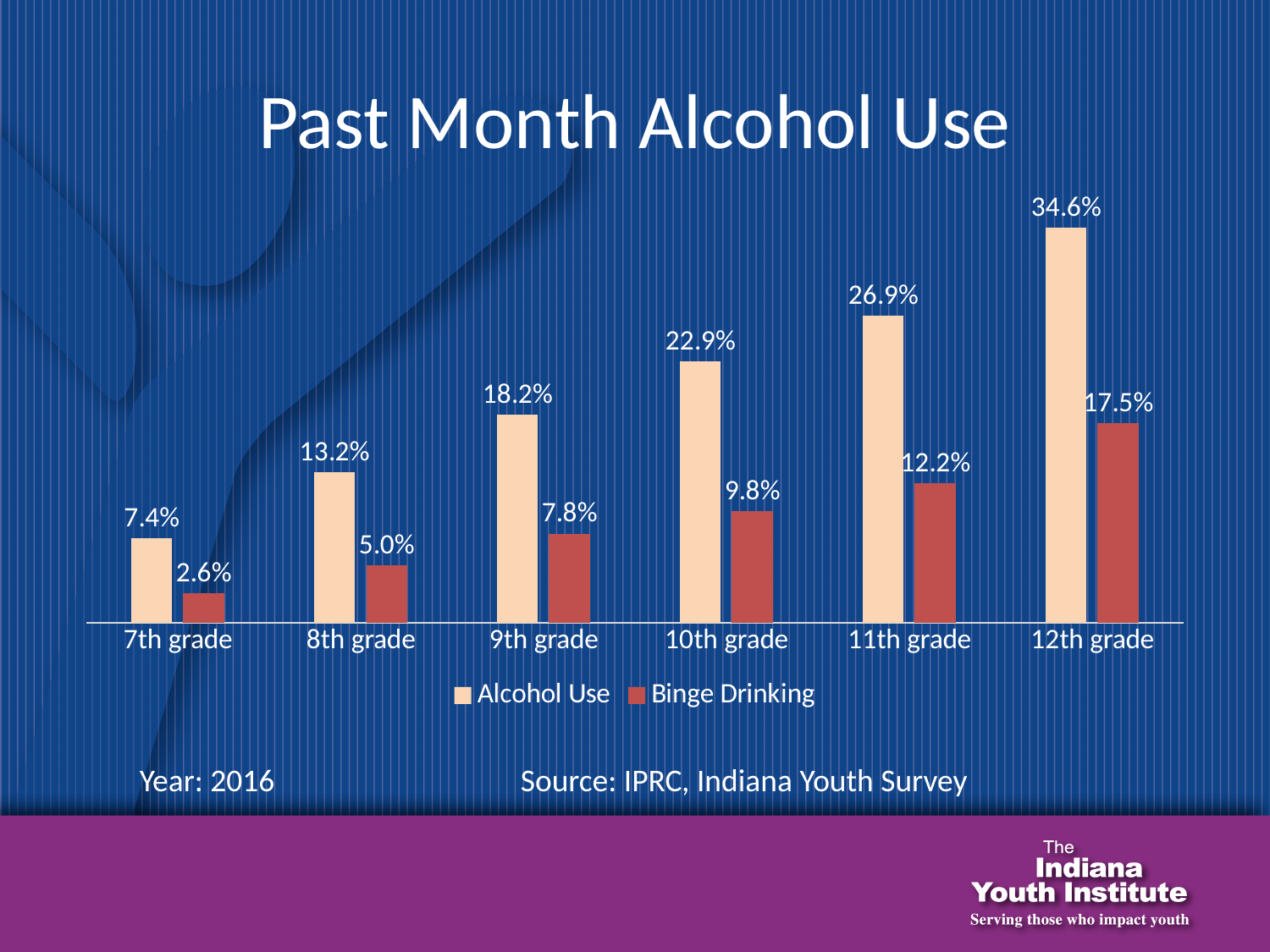
What is the Binge Drinking value for 11th grade? 12.2% What is the Alcohol Use value for 9th grade? 18.2% Do the Alcohol Use values rise or fall from 7th grade to 12th grade? Rise Which grade has the lowest Binge Drinking value? 7th grade Which is larger: the Binge Drinking value for 10th grade or the Alcohol Use value for 7th grade? Binge Drinking for 10th grade How many series does the legend list? 2 What is the Binge Drinking value for 7th grade? 2.6% What kind of chart is shown on the slide? Bar chart What is the difference between the Alcohol Use values for 10th grade and 8th grade? 9.7% Which grade has the highest Alcohol Use value? 12th grade What is the difference between the Alcohol Use and Binge Drinking values for 12th grade? 17.1% How many grade categories are shown on the x axis? 6